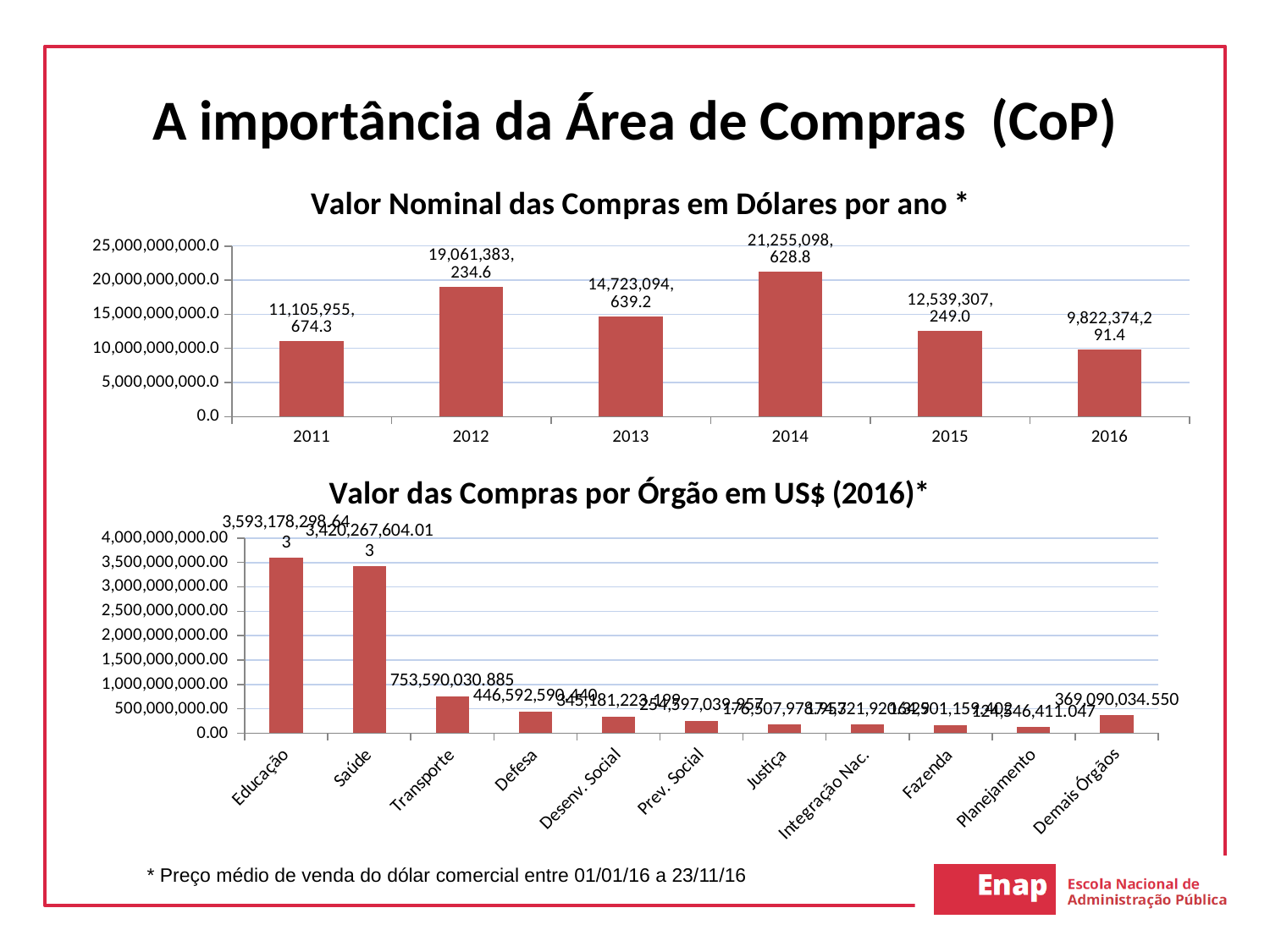
How many years are shown in the top chart 'Valor Nominal das Compras em Dólares por ano'? 6 What kind of chart is the top chart, 'Valor Nominal das Compras em Dólares por ano'? bar chart In the top chart 'Valor Nominal das Compras em Dólares por ano', what is the value for 2014? 21,255,098,628.8 How many categories are shown in the bottom chart 'Valor das Compras por Órgão em US$ (2016)'? 11 In the top chart 'Valor Nominal das Compras em Dólares por ano', what is the difference between the values for 2014 and 2011? 10,149,142,954.5 In the bottom chart 'Valor das Compras por Órgão em US$ (2016)', what is the value for Transporte? 753,590,030.885 In the bottom chart 'Valor das Compras por Órgão em US$ (2016)', which category has the highest value? Educação In the top chart 'Valor Nominal das Compras em Dólares por ano', which year has the highest value? 2014 In the top chart 'Valor Nominal das Compras em Dólares por ano', is the value for 2015 greater or less than 15,000,000,000.0? less In the top chart 'Valor Nominal das Compras em Dólares por ano', which year has the lowest value? 2016 In the top chart 'Valor Nominal das Compras em Dólares por ano', which is larger, the value for 2012 or the value for 2013? 2012 In the bottom chart 'Valor das Compras por Órgão em US$ (2016)', is the value for Saúde greater or less than 3,000,000,000.00? greater